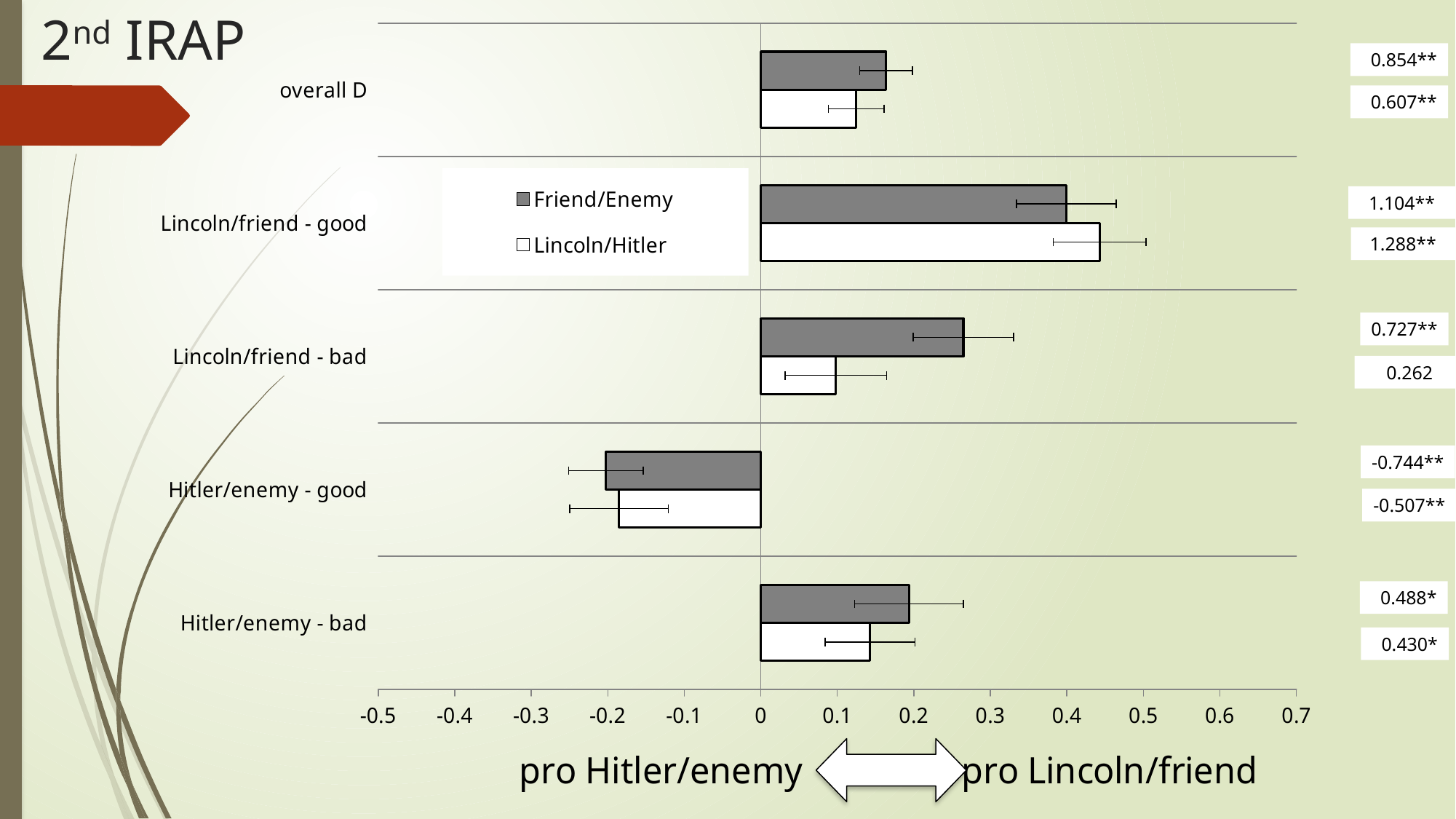
How many series does the legend list? 2 Is the Lincoln/Hitler value for Lincoln/friend - bad greater or less than 0.2? less What statistic is printed to the right of the Friend/Enemy bar for overall D? 0.854** How many categories are plotted on the y axis? 5 For Lincoln/friend - bad, which series has the larger value, Friend/Enemy or Lincoln/Hitler? Friend/Enemy Is the Friend/Enemy value for Lincoln/friend - good greater or less than 0.3? greater What kind of chart is shown on the slide? bar chart Which category has the highest Friend/Enemy value? Lincoln/friend - good Is the Friend/Enemy value for Hitler/enemy - good greater or less than -0.1? less What are the two entries in the chart legend? Friend/Enemy and Lincoln/Hitler Which category has the lowest Lincoln/Hitler value? Hitler/enemy - good